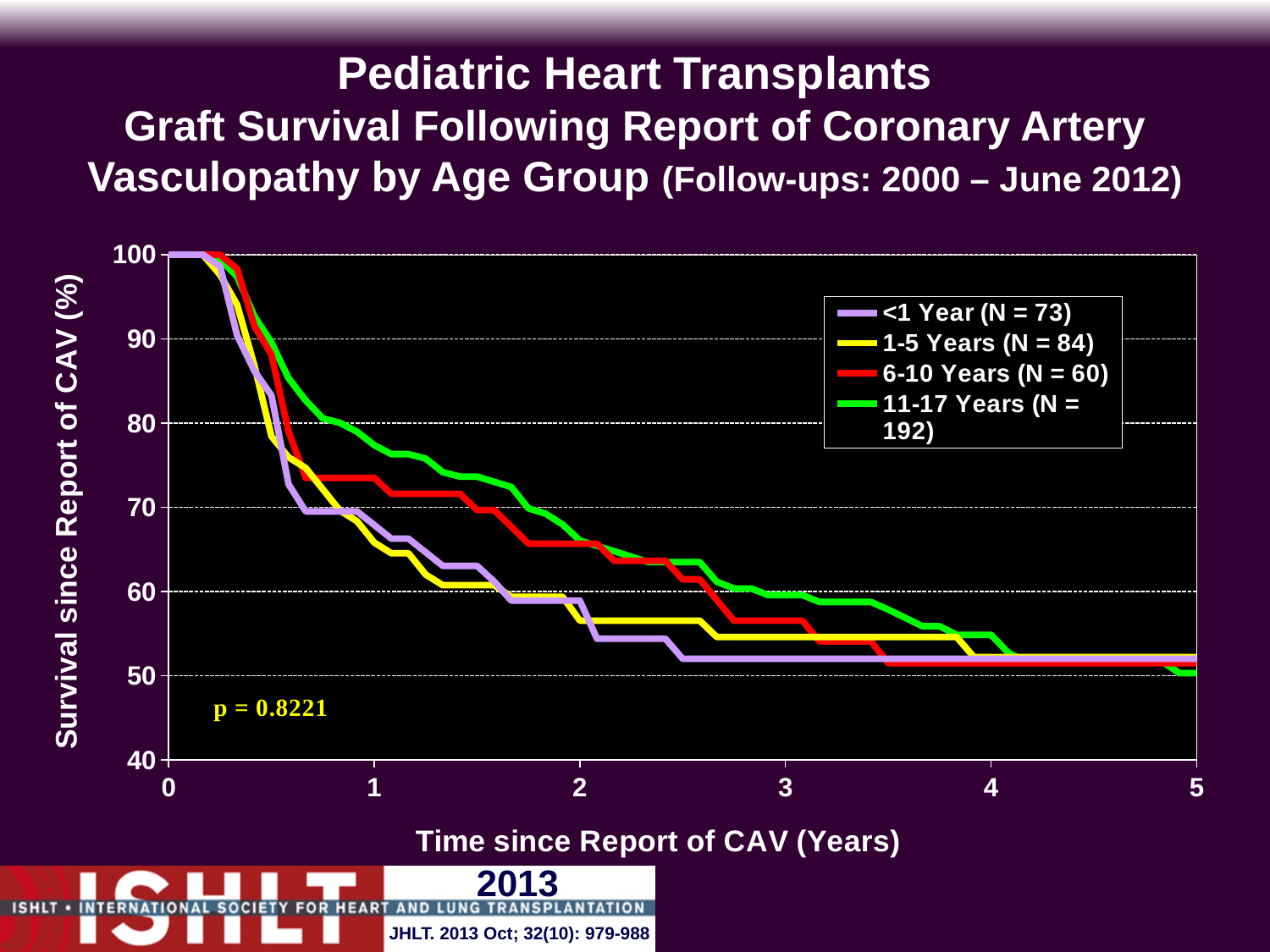
Is the survival value for the 11-17 Years group at 1 year greater or less than 70? greater At 2 years since report of CAV, which group has higher survival: 11-17 Years or 1-5 Years? 11-17 Years Is the survival value for the <1 Year group at 2 years greater or less than 60? less Which age group in the legend has the largest N? 11-17 Years (N = 192) Which age group has the highest survival at 2 years since report of CAV? 11-17 Years Is the survival value for the 6-10 Years group at 3 years greater or less than 60? less How many series does the legend list? 4 At 1 year since report of CAV, which group has higher survival: 11-17 Years or <1 Year? 11-17 Years What p-value is printed on the chart? p = 0.8221 Do the survival curves rise or fall as time since report of CAV increases? fall What kind of chart is shown on the slide? line chart